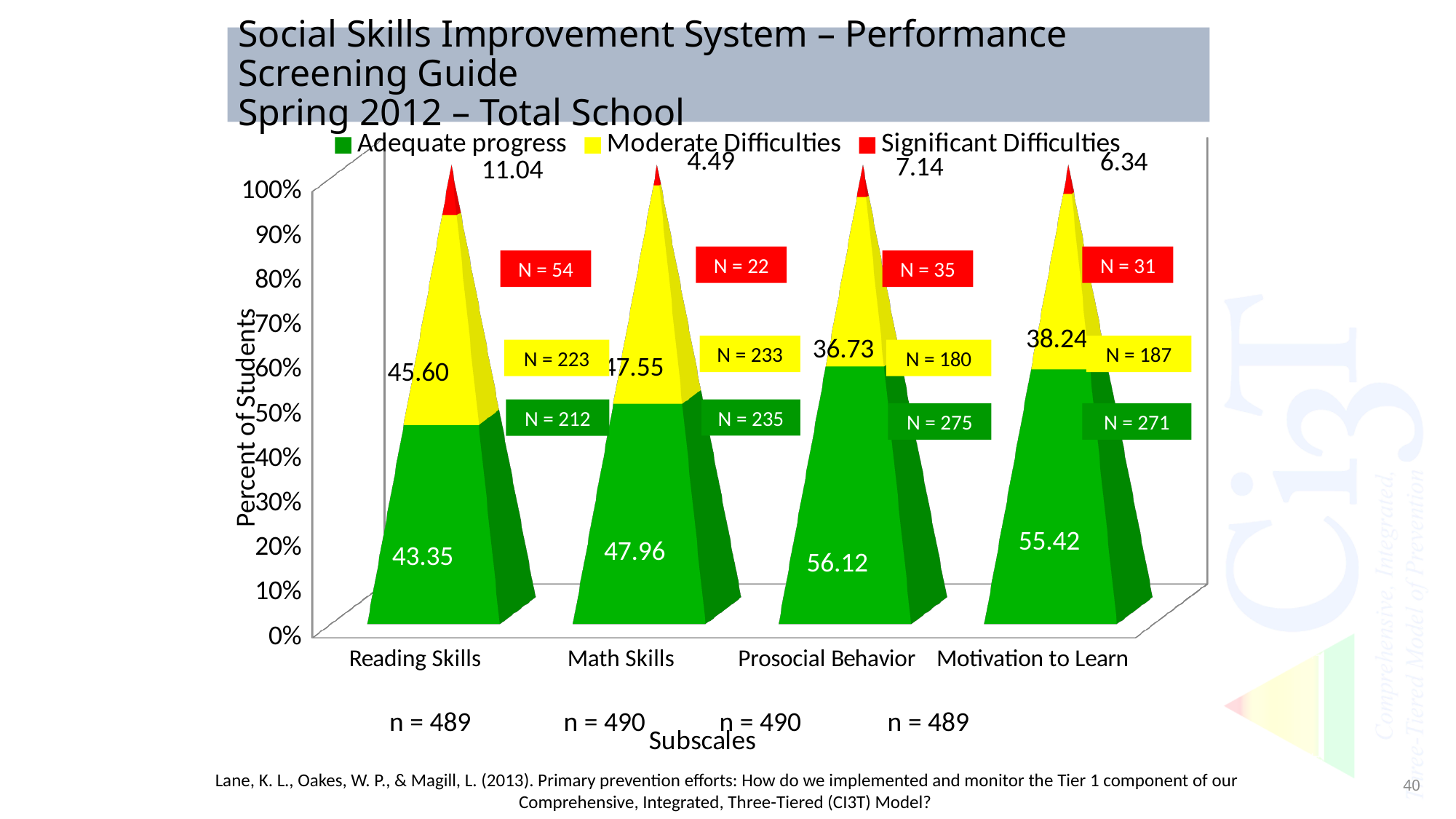
What is the title of the y axis? Percent of Students Which subscale has the lowest Significant Difficulties value? Math Skills What is the Adequate progress value for Prosocial Behavior? 56.12 For Math Skills, which is larger: the Adequate progress value or the Moderate Difficulties value? Adequate progress How many subscales are shown on the x axis? 4 Which subscale has the highest Adequate progress value? Prosocial Behavior What is the Significant Difficulties value for Reading Skills? 11.04 What is the N shown for Moderate Difficulties in Math Skills? N = 233 What kind of chart is shown on the slide? Stacked bar chart How many series does the legend list? 3 What is the difference between the Moderate Difficulties values for Reading Skills and Prosocial Behavior? 8.87 What is the Moderate Difficulties value for Motivation to Learn? 38.24